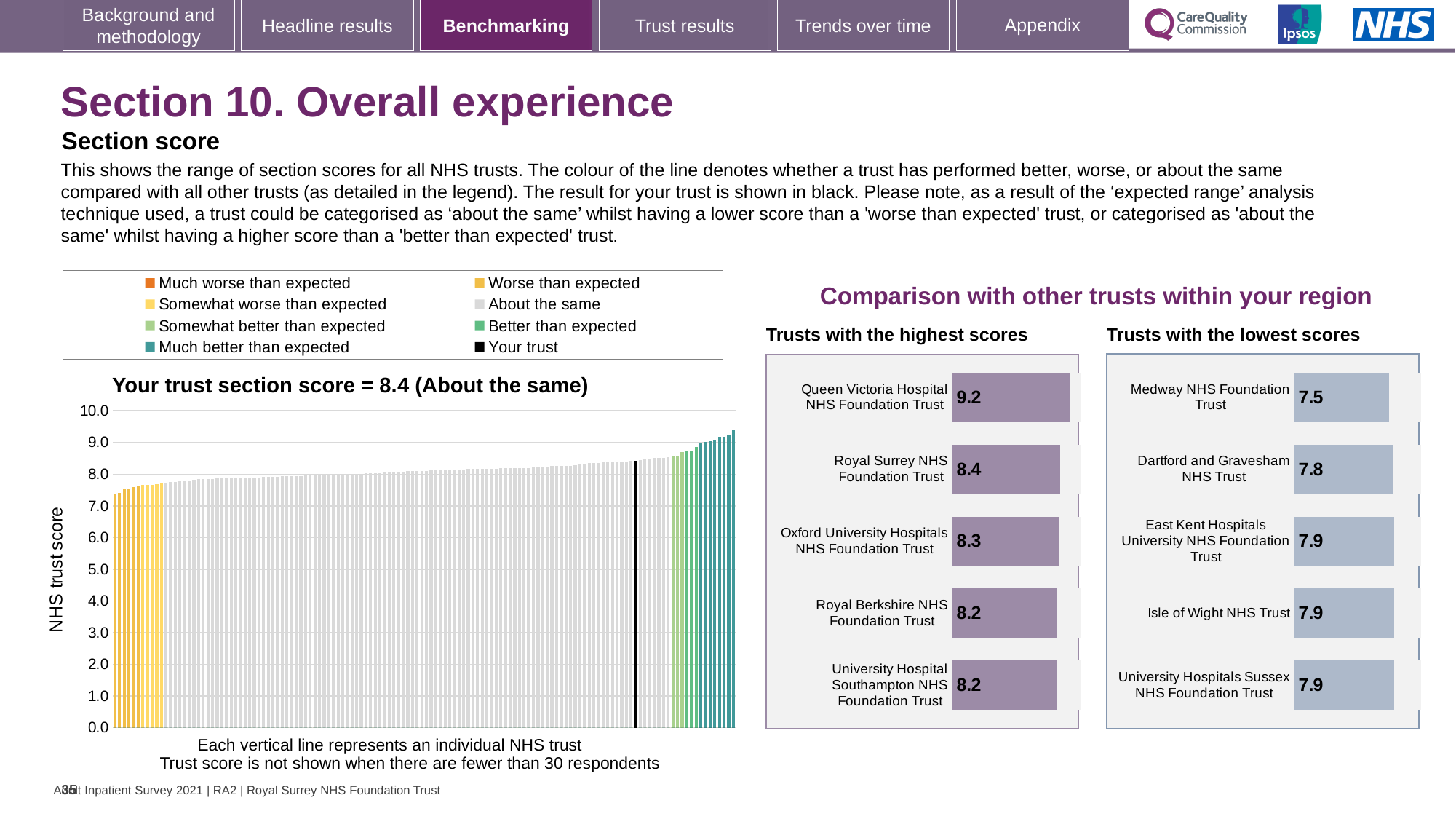
In the 'Trusts with the highest scores' chart, which trust has the highest score? Queen Victoria Hospital NHS Foundation Trust In the 'Trusts with the lowest scores' chart, what is the score for Medway NHS Foundation Trust? 7.5 In the 'Trusts with the lowest scores' chart, what is the score for Dartford and Gravesham NHS Trust? 7.8 In the 'Trusts with the lowest scores' chart, which trust has the lowest score? Medway NHS Foundation Trust In the 'Your trust section score' chart, what is the label on the vertical axis? NHS trust score How many trusts are listed in the 'Trusts with the highest scores' chart? 5 In the 'Trusts with the lowest scores' chart, which has the larger score: Medway NHS Foundation Trust or Dartford and Gravesham NHS Trust? Dartford and Gravesham NHS Trust In the 'Trusts with the highest scores' chart, what is the score for Oxford University Hospitals NHS Foundation Trust? 8.3 In the 'Trusts with the highest scores' chart, what is the score for Queen Victoria Hospital NHS Foundation Trust? 9.2 What kind of chart is the 'Your trust section score' chart? Bar chart In the 'Your trust section score' chart, what is the section score for your trust? 8.4 In the 'Trusts with the highest scores' chart, what is the difference between the scores of Queen Victoria Hospital NHS Foundation Trust and Royal Surrey NHS Foundation Trust? 0.8